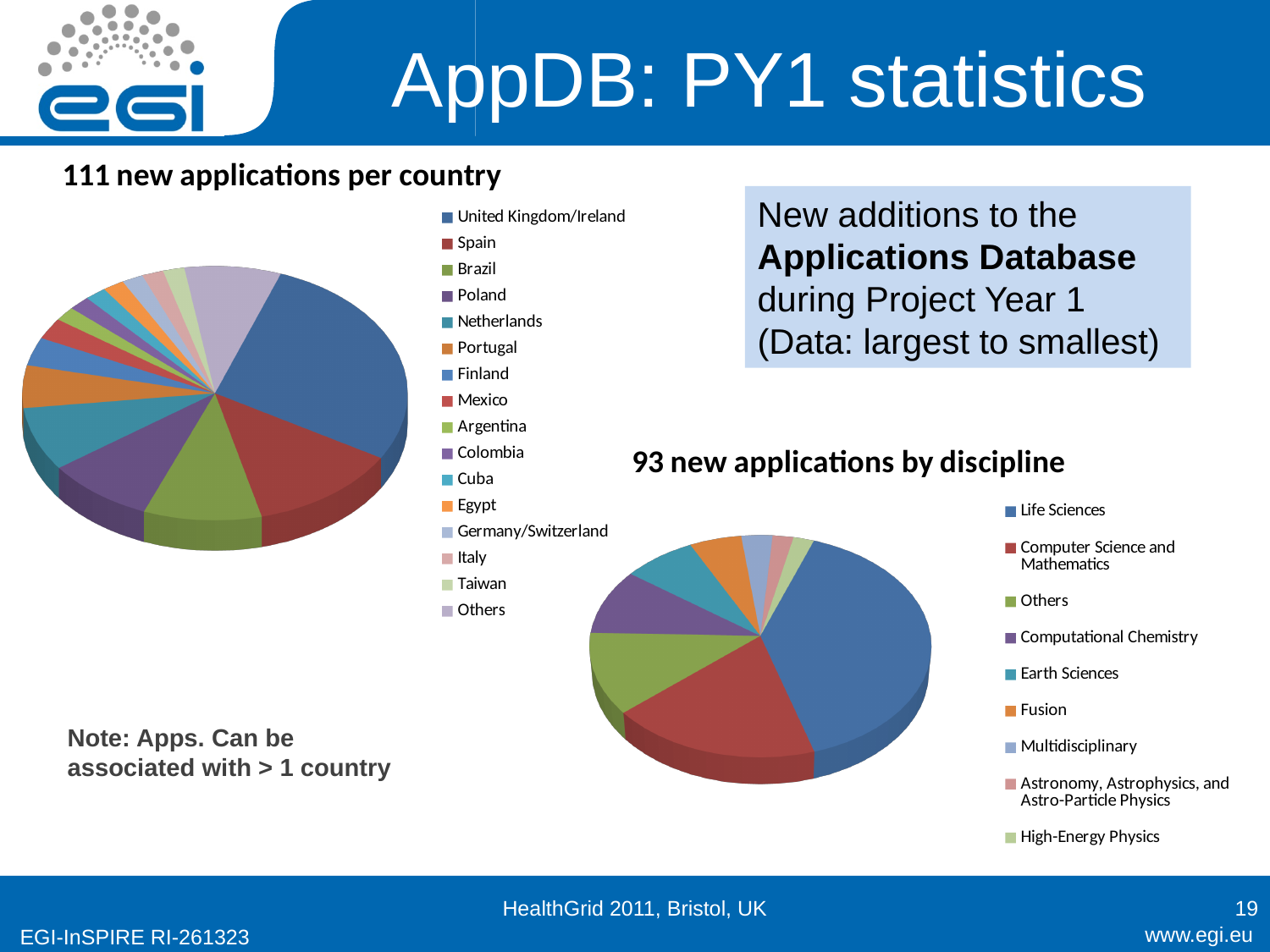
In the "93 new applications by discipline" chart, which slice is larger, Computer Science and Mathematics or Others? Computer Science and Mathematics How many categories does the legend of the "93 new applications by discipline" chart list? 9 In the "93 new applications by discipline" chart, which discipline is listed last in the legend? High-Energy Physics What kind of chart is the "93 new applications by discipline" chart? pie chart In the "111 new applications per country" chart, which slice is larger, United Kingdom/Ireland or Spain? United Kingdom/Ireland What is the title of the pie chart on the left of the slide? 111 new applications per country In the "93 new applications by discipline" chart, which discipline has the largest slice? Life Sciences In the "111 new applications per country" chart, which slice is larger, Spain or Brazil? Spain How many categories does the legend of the "111 new applications per country" chart list? 16 What kind of chart is the "111 new applications per country" chart? pie chart In the "111 new applications per country" chart, which country has the largest slice? United Kingdom/Ireland